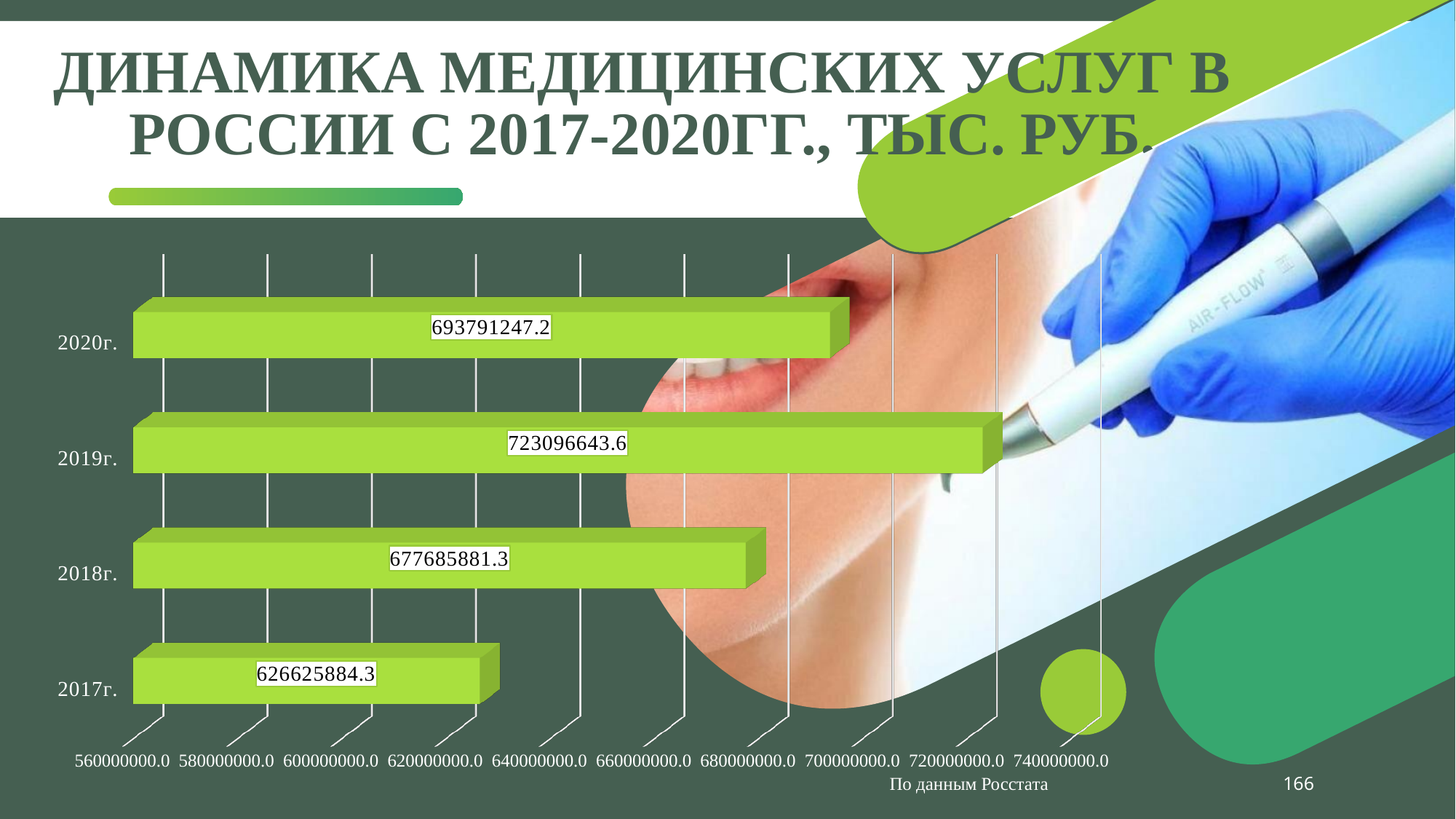
What is the value for 2018г.? 677685881.3 What is the difference between the values for 2018г. and 2017г.? 51059997.0 What is the value for 2017г.? 626625884.3 Which year has the highest value? 2019г. How many years are shown in the chart? 4 Do the values rise or fall from 2017г. to 2019г.? rise Which is larger, the value for 2020г. or the value for 2018г.? 2020г. What kind of chart is shown on the slide? bar chart What is the value for 2020г.? 693791247.2 Which year has the lowest value? 2017г. Is the value for 2017г. greater or less than 640000000.0? less What is the difference between the values for 2019г. and 2020г.? 29305396.4